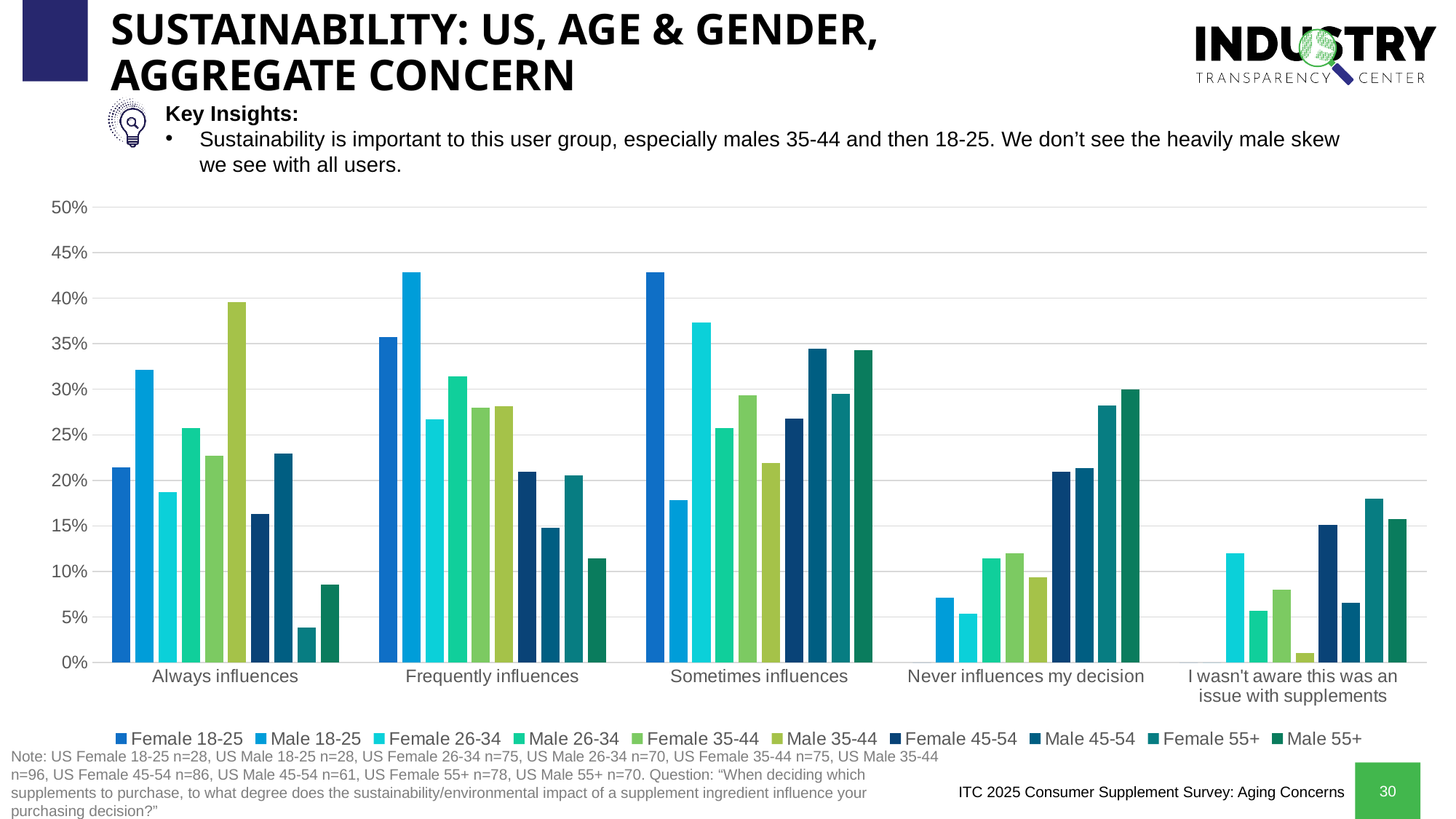
How many series does the legend list? 10 In the 'Always influences' category, which is larger: Male 18-25 or Female 18-25? Male 18-25 What kind of chart is shown on the slide? Bar chart How many response categories are shown along the x axis? 5 In the 'Always influences' category, which group has the lowest value? Female 55+ In the 'Frequently influences' category, which is larger: Female 18-25 or Female 26-34? Female 18-25 What is the title of the slide containing the chart? Sustainability: US, Age & Gender, Aggregate Concern In the 'Sometimes influences' category, which group has the highest value? Female 18-25 Is the value for Female 18-25 in 'Sometimes influences' greater or less than 40%? greater Is the value for Male 35-44 in 'I wasn't aware this was an issue with supplements' greater or less than 5%? less In the 'Always influences' category, which group has the highest value? Male 35-44 Is the value for Male 18-25 in 'Frequently influences' greater or less than 40%? greater